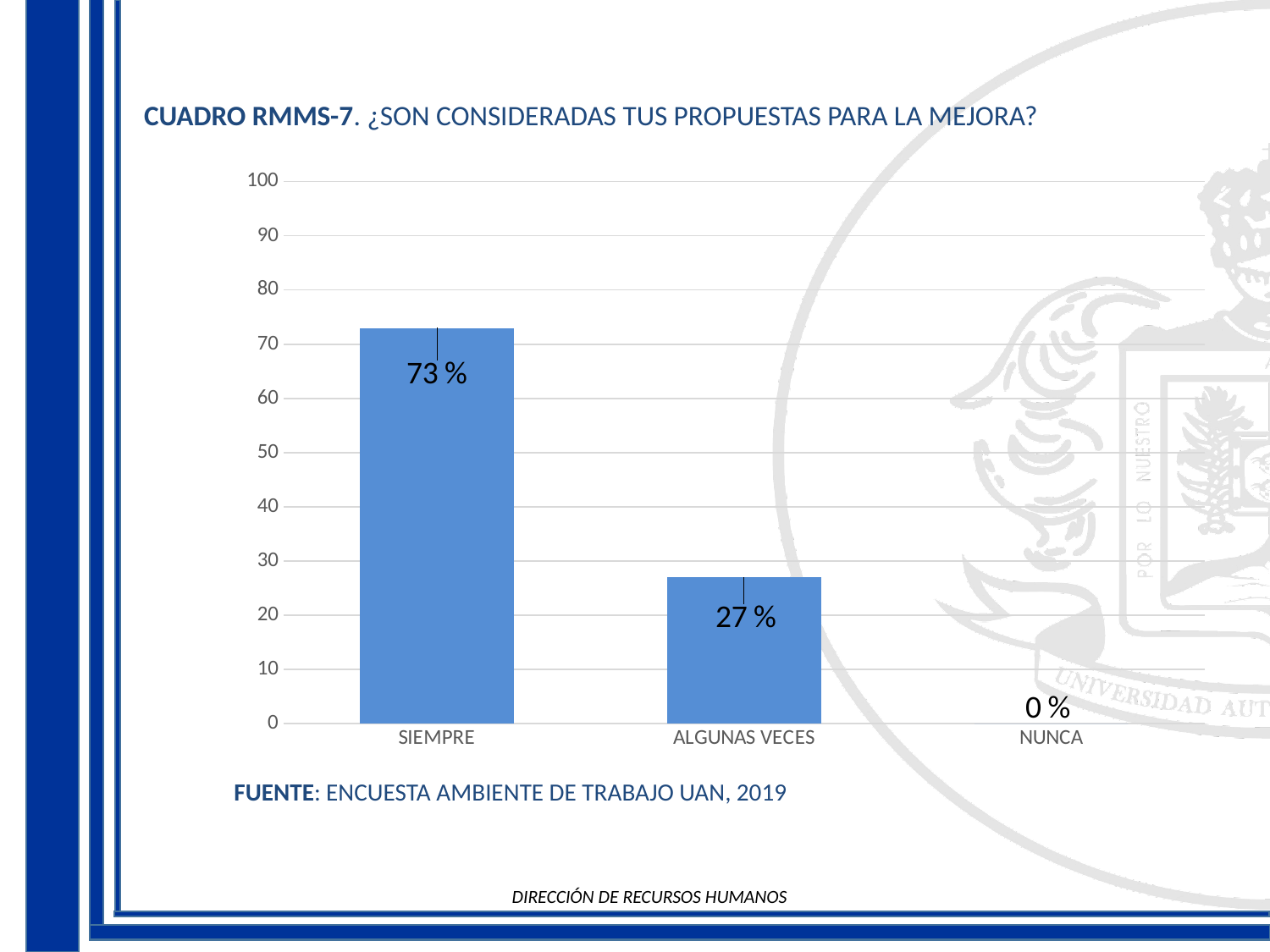
What is the value for NUNCA? 0 % Is the value for SIEMPRE greater or less than 70? greater Which category has the highest value? SIEMPRE What is the value for ALGUNAS VECES? 27 % What is the difference between the values for SIEMPRE and ALGUNAS VECES? 46 % How many categories are shown on the x axis? 3 What source is cited below the chart? ENCUESTA AMBIENTE DE TRABAJO UAN, 2019 Which category has the lowest value? NUNCA What is the value for SIEMPRE? 73 % Is the value for ALGUNAS VECES greater or less than 30? less Which is larger, the value for SIEMPRE or the value for ALGUNAS VECES? SIEMPRE What kind of chart is shown on the slide? bar chart